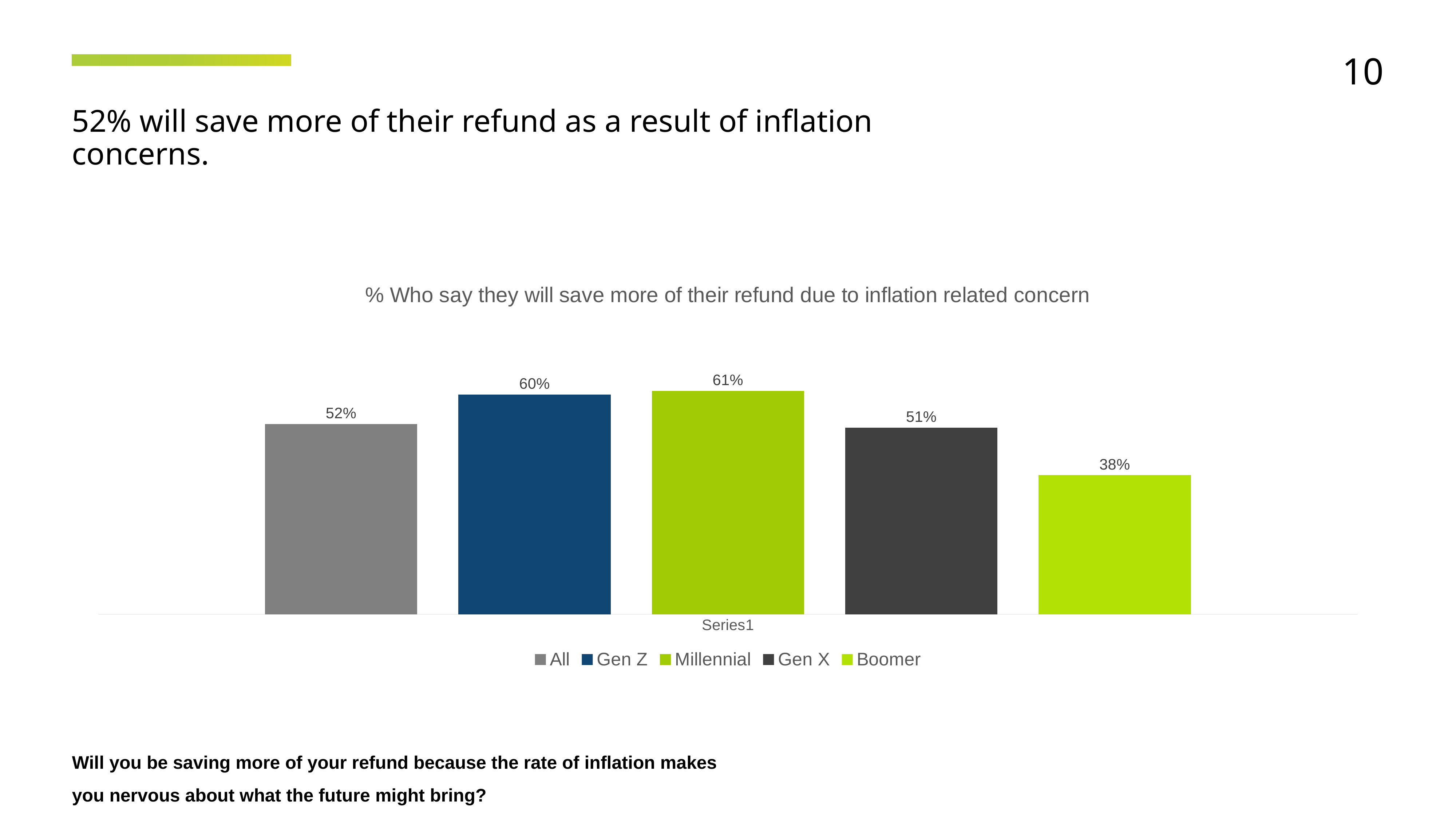
What is the value shown for Boomer? 38% What percentage of Gen Z say they will save more of their refund due to inflation related concern? 60% Which group has the lowest percentage saying they will save more of their refund? Boomer What is the value shown for All? 52% Which group has the highest percentage saying they will save more of their refund? Millennial Which is larger, the value for Gen Z or the value for Gen X? Gen Z What is the value shown for Gen X? 51% What is the difference between the Gen Z value and the All value? 8% What is the title of the chart? % Who say they will save more of their refund due to inflation related concern How many groups are shown in the chart? 5 What type of chart is shown on the slide? Bar chart What is the difference between the Millennial value and the Boomer value? 23%